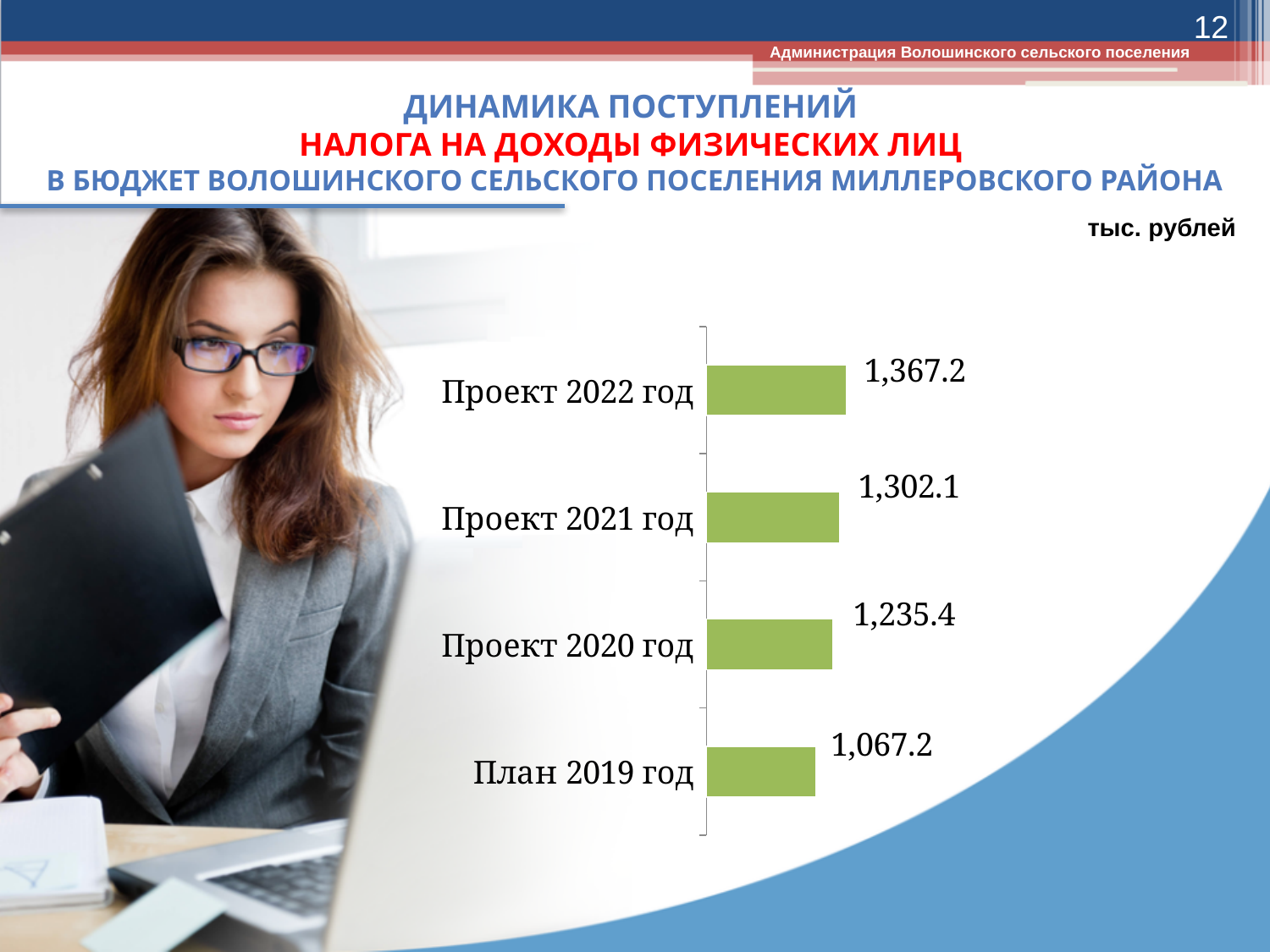
What is the value for Проект 2021 год? 1,302.1 Which category has the highest value? Проект 2022 год What is the value for Проект 2020 год? 1,235.4 How many categories are shown in the chart? 4 What kind of chart is shown on the slide? Bar chart Which is larger, the value for Проект 2021 год or Проект 2020 год? Проект 2021 год What is the difference between the values for Проект 2021 год and Проект 2020 год? 66.7 Which category has the lowest value? План 2019 год What is the value for План 2019 год? 1,067.2 Do the values rise or fall from План 2019 год to Проект 2022 год? Rise What is the difference between the values for Проект 2022 год and План 2019 год? 300.0 What is the value for Проект 2022 год? 1,367.2